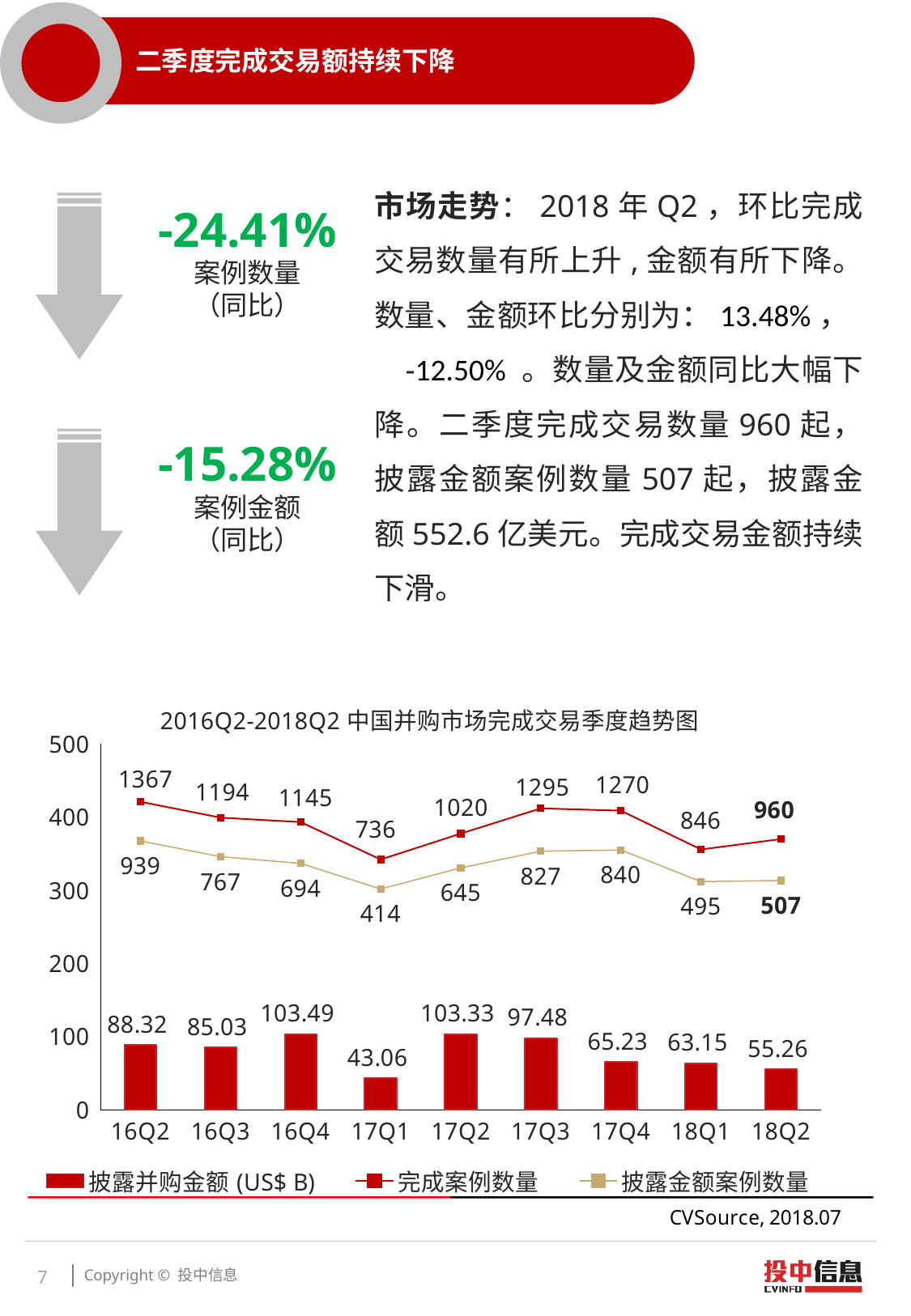
How many quarters are shown on the x axis? 9 Which quarter has the lowest 完成案例数量? 17Q1 Which quarter has the highest 披露并购金额 (US$ B)? 16Q4 How many series does the legend list? 3 Does the 披露并购金额 (US$ B) rise or fall from 17Q2 to 18Q2? Fall What is the 披露金额案例数量 value for 17Q4? 840 What kind of chart is this? Combined bar and line chart What is the title of the chart? 2016Q2-2018Q2 中国并购市场完成交易季度趋势图 What is the difference between the 完成案例数量 and the 披露金额案例数量 in 18Q2? 453 What is the 完成案例数量 value for 18Q2? 960 What is the 披露并购金额 (US$ B) value for 17Q1? 43.06 Which is larger, the 披露并购金额 (US$ B) for 16Q2 or for 16Q3? 16Q2